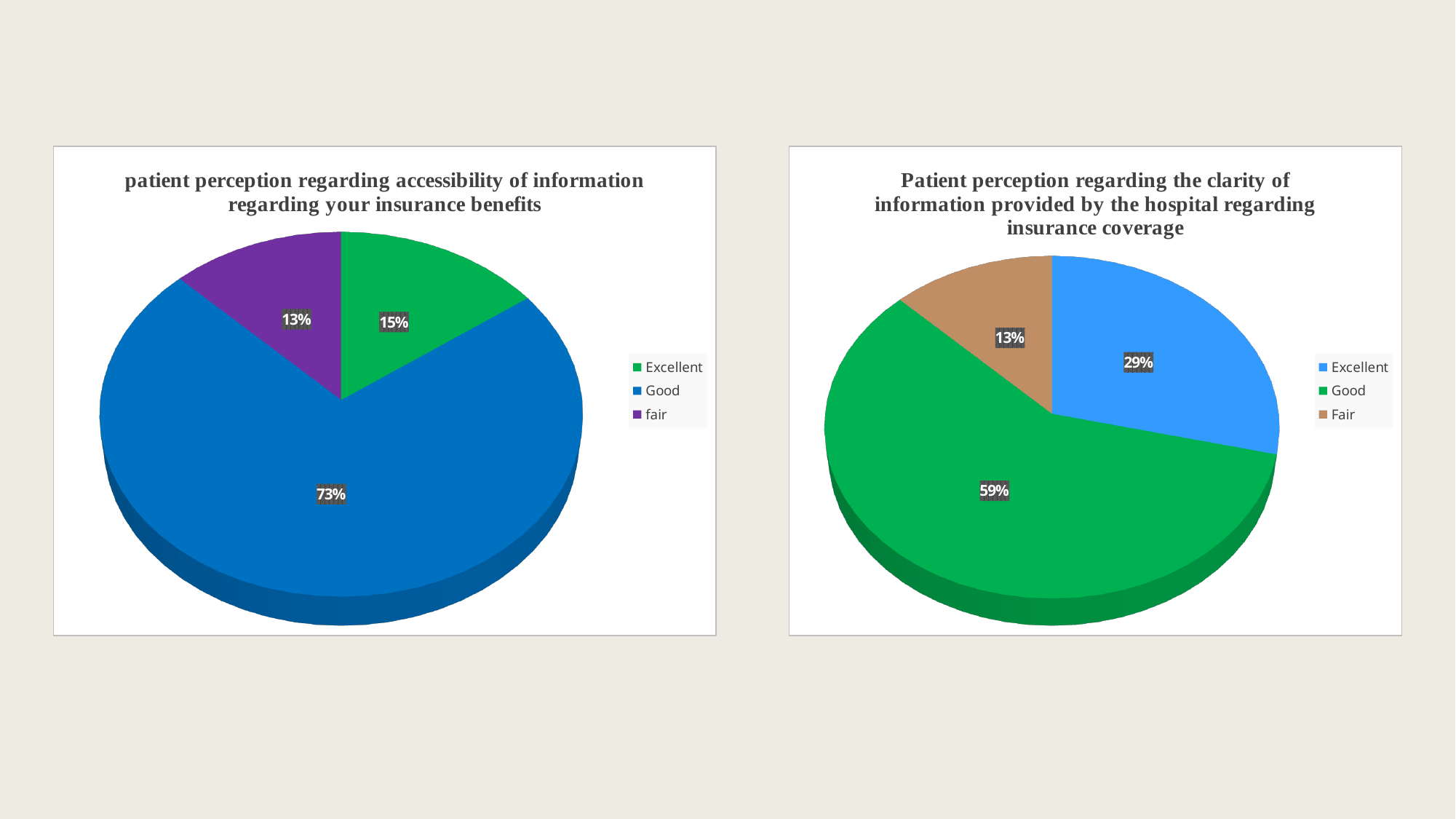
In the right chart (clarity of information regarding insurance coverage), which category has the smallest share? Fair In the left chart (accessibility of information regarding insurance benefits), what is the difference in percentage points between the Good and Excellent shares? 58 How many categories does the legend of the right chart (clarity of information regarding insurance coverage) list? 3 In the left chart (accessibility of information regarding insurance benefits), what share of patients rated it fair? 13% In the left chart (accessibility of information regarding insurance benefits), what share of patients rated it Good? 73% In the right chart (clarity of information provided by the hospital regarding insurance coverage), what share of patients rated it Good? 59% What type of chart is the left chart (accessibility of information regarding insurance benefits)? Pie chart In the right chart (clarity of information provided by the hospital regarding insurance coverage), what share of patients rated it Excellent? 29% In the right chart (clarity of information regarding insurance coverage), which is larger, the Excellent share or the Fair share? Excellent In the left chart (accessibility of information regarding insurance benefits), what share of patients rated it Excellent? 15% In the right chart (clarity of information provided by the hospital regarding insurance coverage), what share of patients rated it Fair? 13% In the left chart (accessibility of information regarding insurance benefits), which category has the largest share? Good